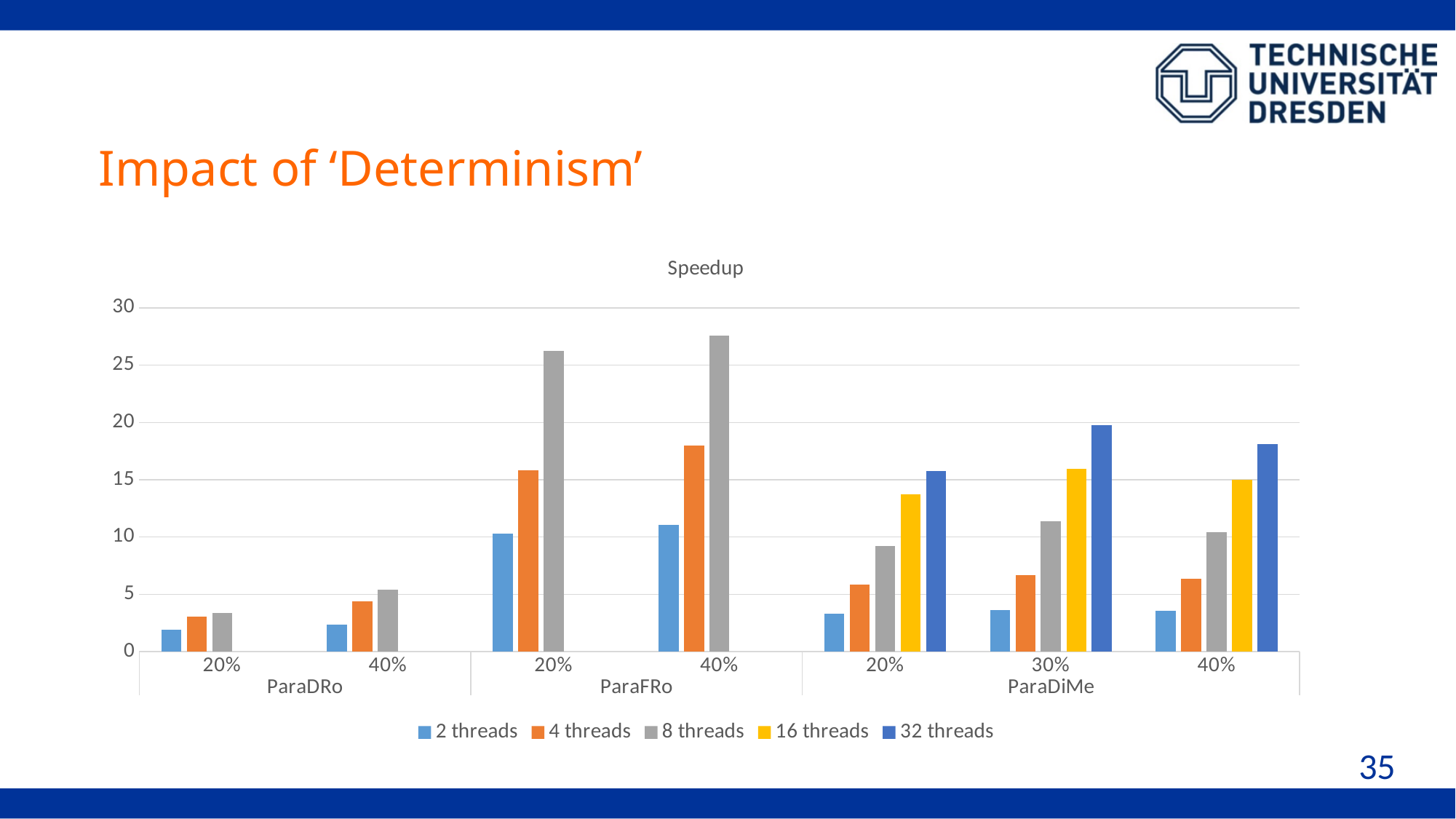
Which bar is the highest in the whole chart? 8 threads at ParaFRo 40% Is the speedup for 2 threads at ParaDRo 20% greater or less than 5? less Is the speedup for 8 threads at ParaFRo 20% greater or less than 25? greater What is the title of the chart? Speedup Which program group is the only one with bars for 16 threads and 32 threads? ParaDiMe How many series does the legend list? 5 Is the speedup for 32 threads at ParaDiMe 30% greater or less than 15? greater Which is larger: the speedup for 8 threads at ParaFRo 20% or for 32 threads at ParaDiMe 30%? 8 threads at ParaFRo 20% Does the speedup for 8 threads in ParaFRo rise or fall from 20% to 40%? rise How many category groups (percentage labels) are shown along the x axis? 7 Which bar is the lowest in the whole chart? 2 threads at ParaDRo 20% What kind of chart is shown on the slide? bar chart